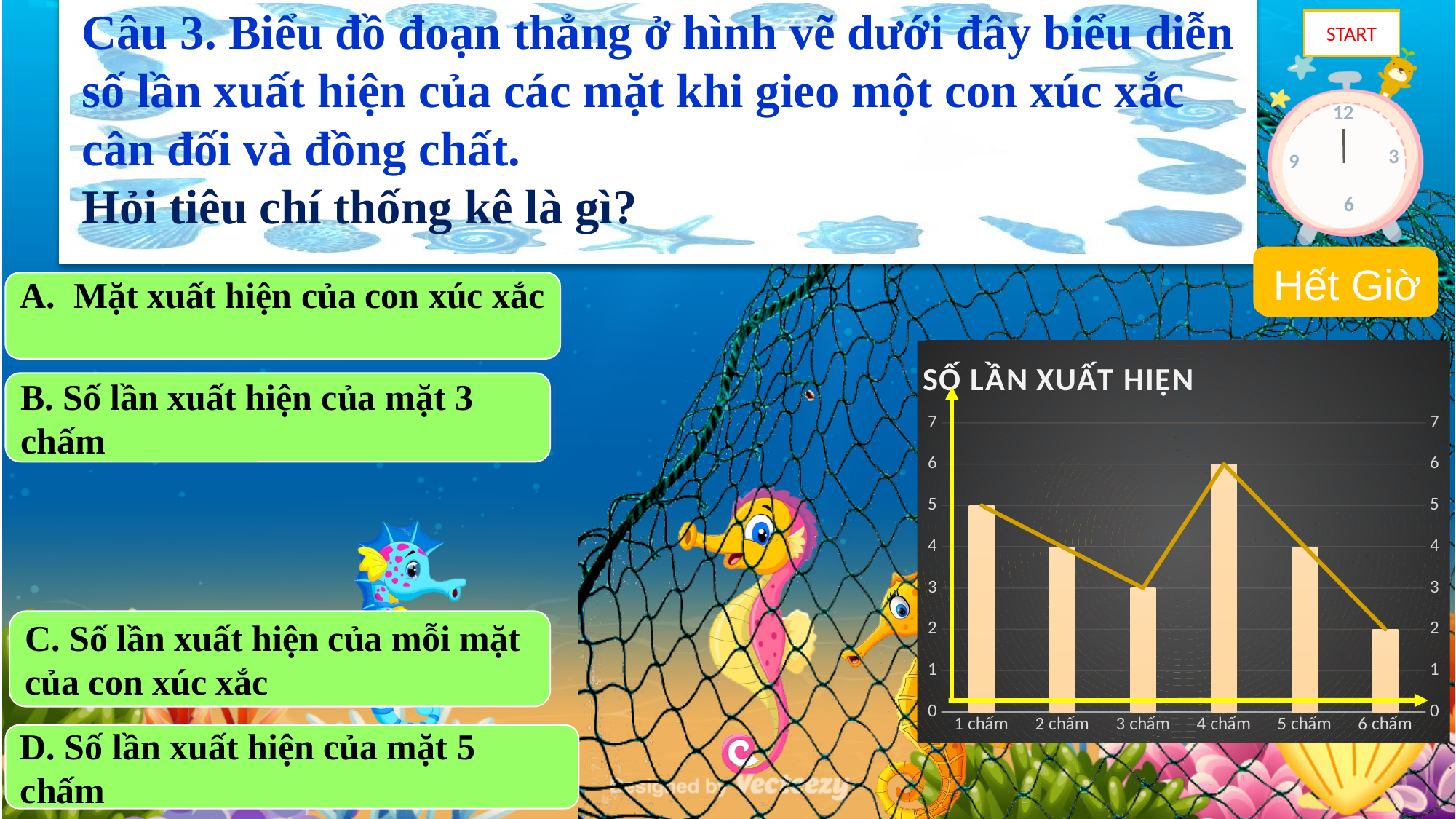
Which category has the lowest value in the chart? 6 chấm Is the value for 4 chấm greater or less than 5? greater What is the value for 3 chấm in the chart? 3 What is the value for 4 chấm in the chart? 6 What is the title of the chart on the slide? SỐ LẦN XUẤT HIỆN Do the values rise or fall from 4 chấm to 6 chấm along the x axis? fall What is the value for 1 chấm in the chart? 5 Which category has the highest value in the chart? 4 chấm How many categories are shown on the x axis of the chart? 6 What is the difference between the values for 4 chấm and 6 chấm? 4 Which is larger, the value for 1 chấm or the value for 2 chấm? 1 chấm What is the value for 6 chấm in the chart? 2